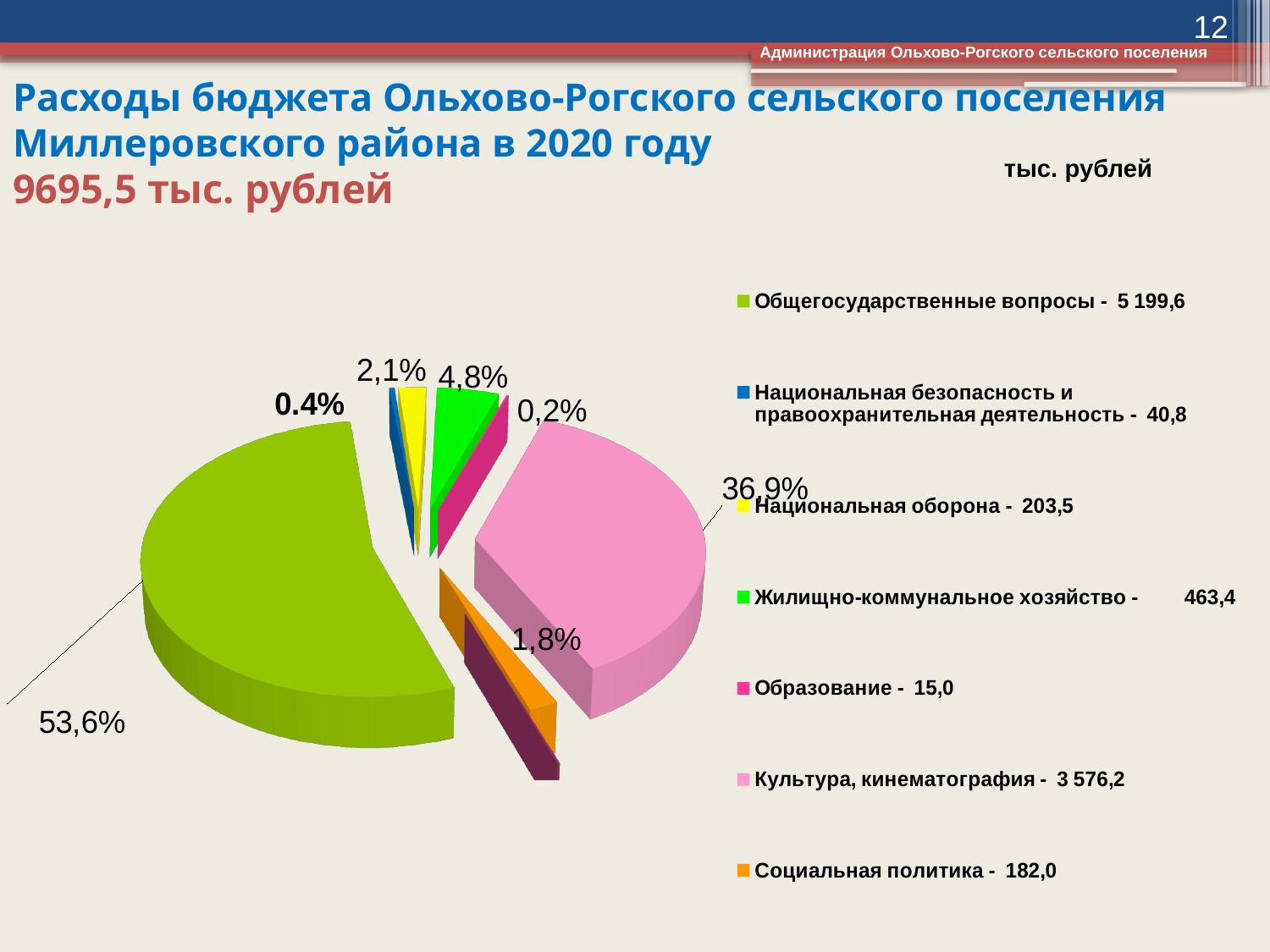
What share of the pie does Культура, кинематография take? 36,9% What is the difference between Общегосударственные вопросы and Культура, кинематография? 1 623,4 What is the value for Национальная безопасность и правоохранительная деятельность? 40,8 Which is larger: Жилищно-коммунальное хозяйство or Национальная оборона? Жилищно-коммунальное хозяйство What kind of chart is shown on the slide? pie chart What share of the pie does Социальная политика take? 1,8% Which category has the highest value? Общегосударственные вопросы How many categories does the legend list? 7 What is the value for Общегосударственные вопросы? 5 199,6 What share of the pie does Общегосударственные вопросы take? 53,6% What is the value for Культура, кинематография? 3 576,2 Which category has the lowest value? Образование